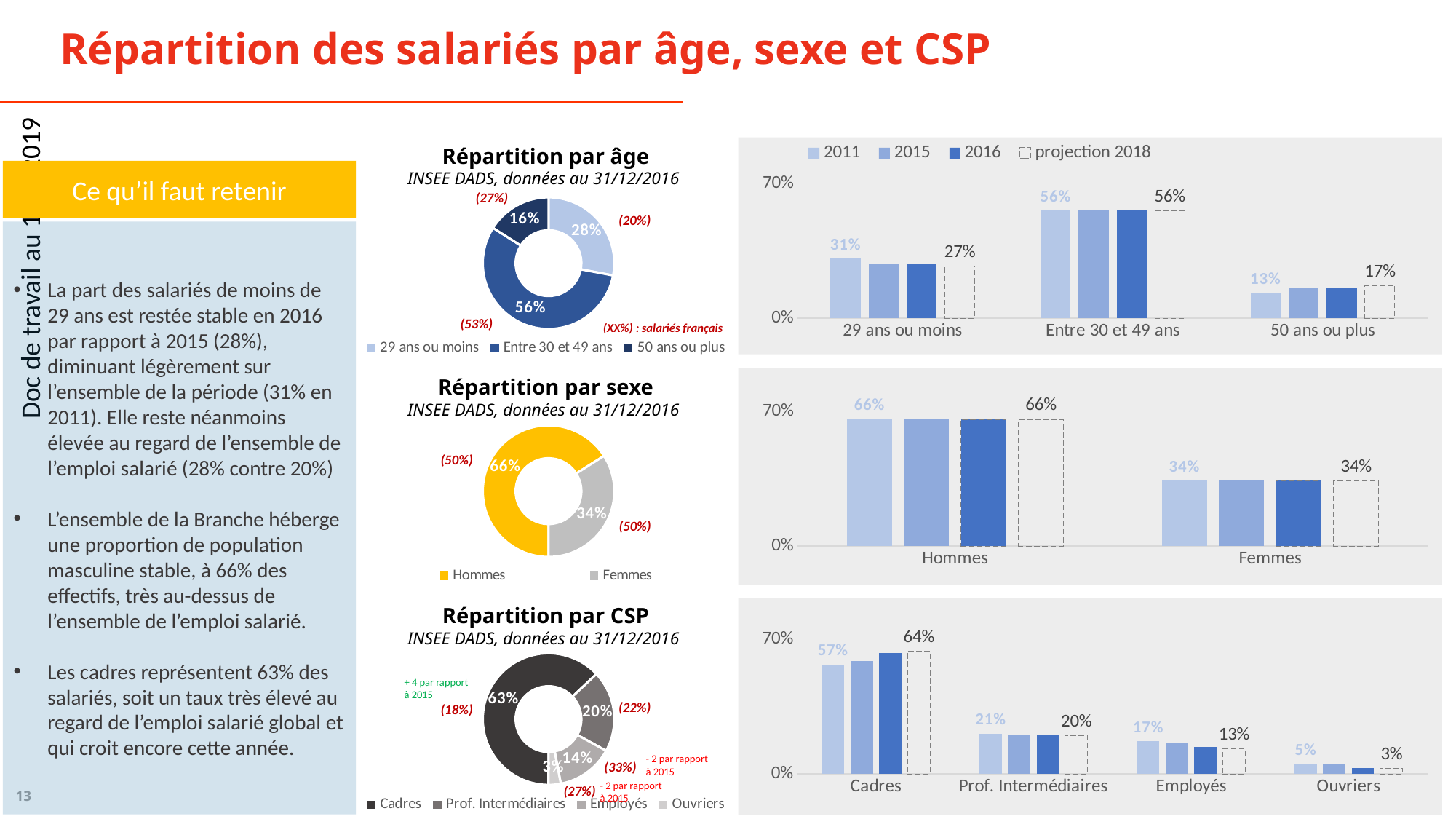
In the top-right bar chart (age by year), how many series does the legend list? 4 In the top-right bar chart (age by year), what is the 'projection 2018' value for '50 ans ou plus'? 17% In the 'Répartition par âge' donut chart, which age category has the smallest share? 50 ans ou plus In the 'Répartition par CSP' donut chart, what is the difference between the shares for 'Cadres' and 'Prof. Intermédiaires'? 43 percentage points In the 'Répartition par sexe' donut chart, what share is shown for 'Hommes'? 66% What kind of chart is the middle-right chart showing 'Hommes' and 'Femmes' by year? Bar chart In the bottom-right bar chart (CSP by year), do the 2011 values rise or fall from 'Cadres' to 'Ouvriers'? Fall In the bottom-right bar chart (CSP by year), how many categories are shown on the x axis? 4 In the 'Répartition par CSP' donut chart, what share is shown for 'Cadres'? 63% In the 'Répartition par âge' donut chart, what share is shown for 'Entre 30 et 49 ans'? 56% In the top-right bar chart (age by year), what is the 2011 value for '29 ans ou moins'? 31% In the bottom-right bar chart (CSP by year), what is the 'projection 2018' value for 'Cadres'? 64%